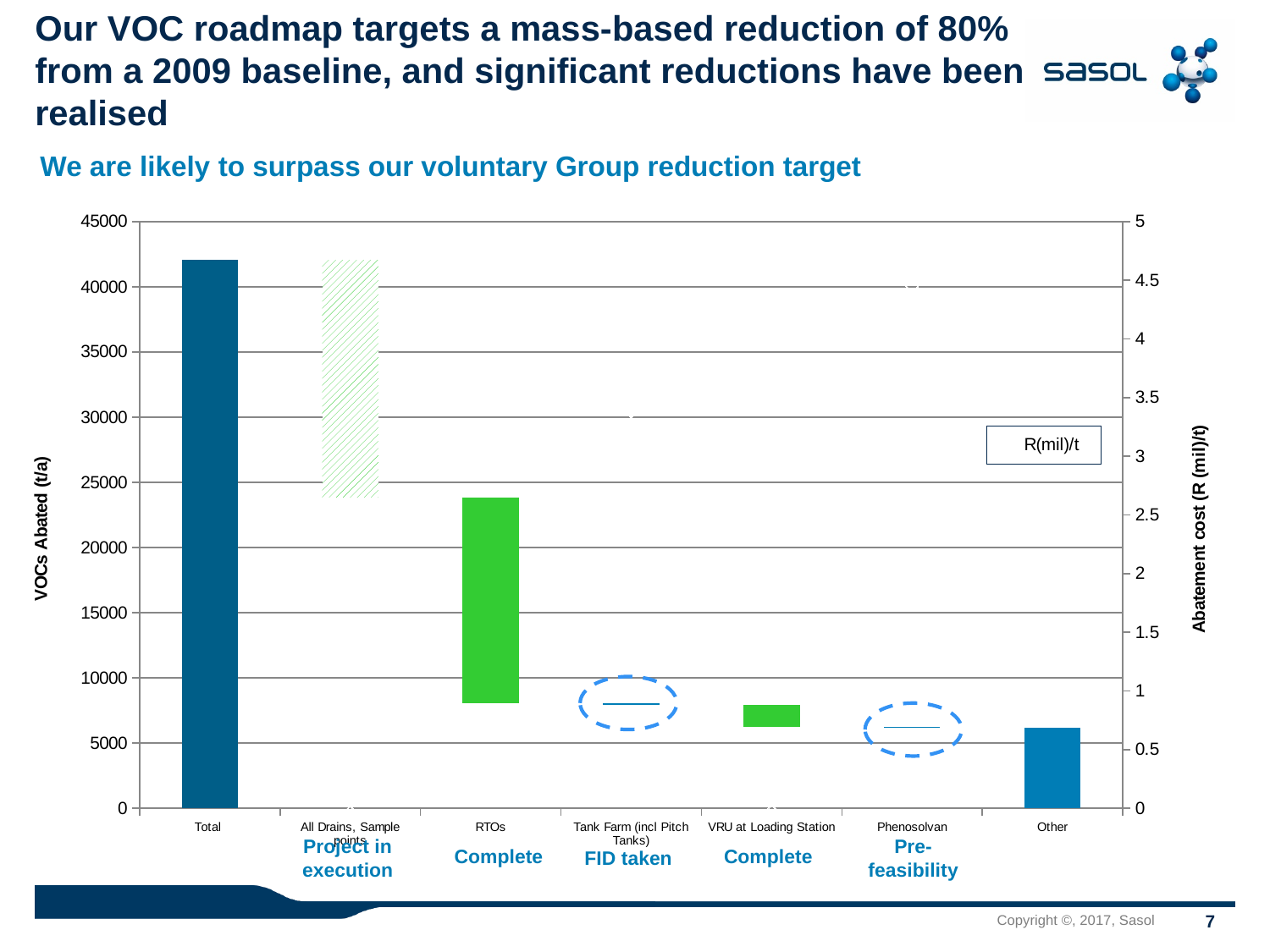
Which category has the tallest bar in the chart? Total What is the title of the right vertical axis of the chart? Abatement cost (R (mil)/t) Is the value for VRU at Loading Station greater or less than 10000? less Is the value for Total greater or less than 40000? greater How many categories are shown along the x axis of the chart? 7 Which bar reaches higher, RTOs or VRU at Loading Station? RTOs Does the top of the RTOs bar reach greater or less than 20000? greater What is the title of the left vertical axis of the chart? VOCs Abated (t/a) Which bar reaches higher, Total or Other? Total How many entries does the chart legend list? 1 What kind of chart is shown on the slide? bar chart